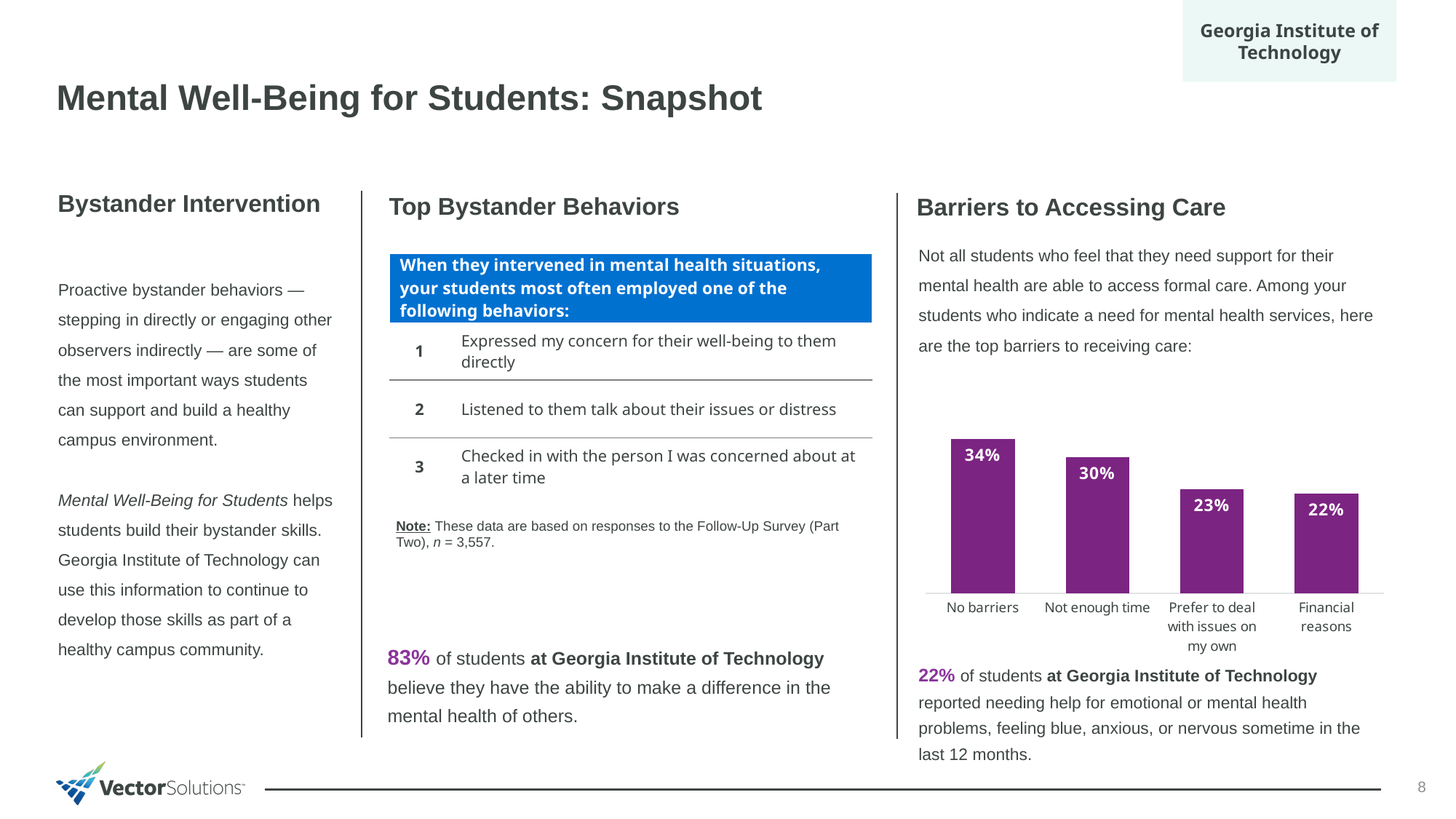
How many categories are shown in the Barriers to Accessing Care chart? 4 What type of chart is used in the Barriers to Accessing Care section? Bar chart Do the values in the Barriers to Accessing Care chart rise or fall from left to right? Fall What percentage of students reported 'No barriers' in the Barriers to Accessing Care chart? 34% What is the value for 'Not enough time' in the Barriers to Accessing Care chart? 30% What is the difference between 'No barriers' and 'Not enough time' in the Barriers to Accessing Care chart? 4% What is the difference between 'Not enough time' and 'Financial reasons' in the Barriers to Accessing Care chart? 8% Which is larger in the Barriers to Accessing Care chart: 'Not enough time' or 'Prefer to deal with issues on my own'? Not enough time Which category has the lowest value in the Barriers to Accessing Care chart? Financial reasons What is the value for 'Prefer to deal with issues on my own' in the Barriers to Accessing Care chart? 23% What is the value for 'Financial reasons' in the Barriers to Accessing Care chart? 22% Which category has the highest value in the Barriers to Accessing Care chart? No barriers